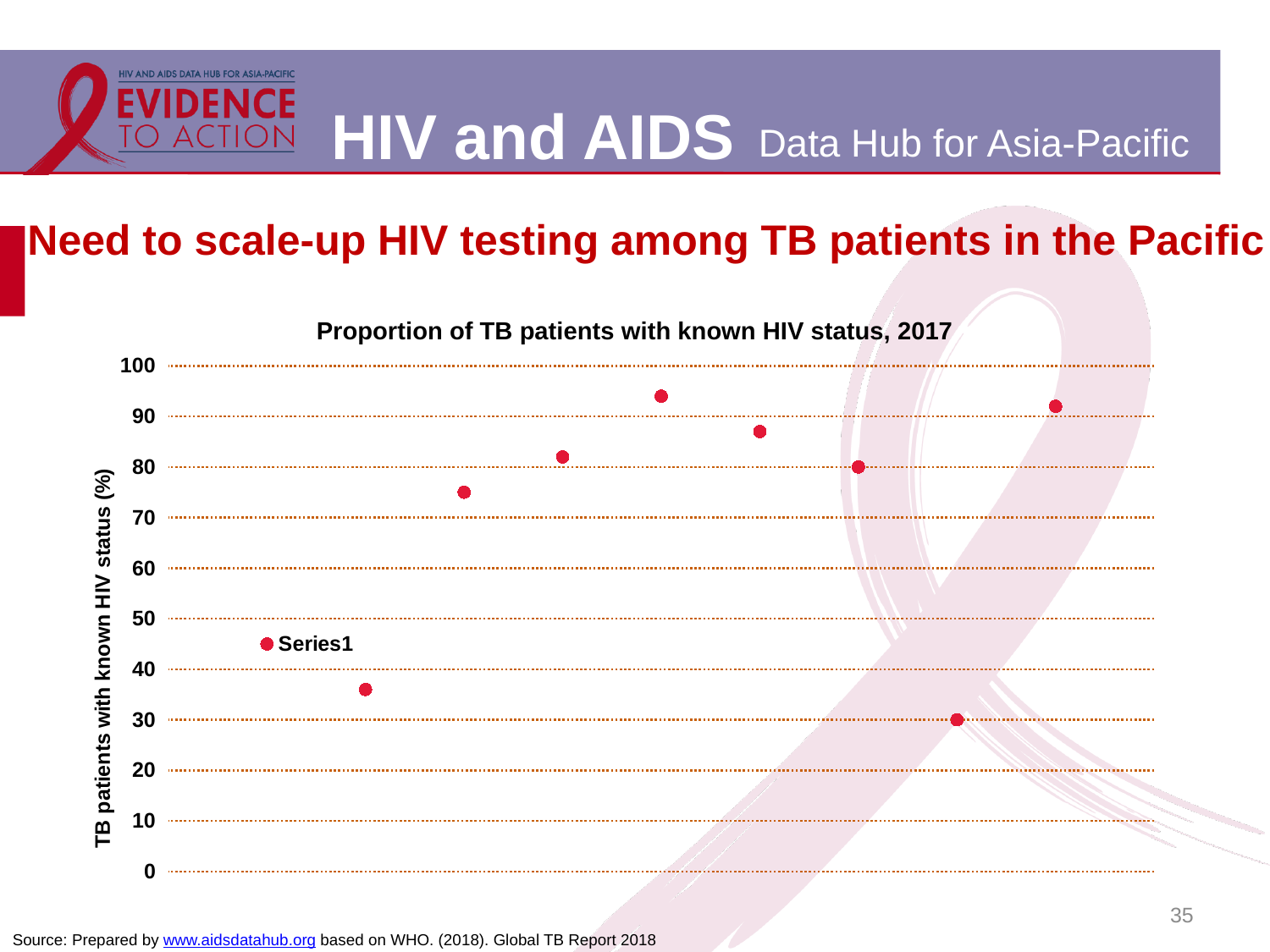
Is the value of the leftmost data point greater or less than 40? greater What is the title of the chart? Proportion of TB patients with known HIV status, 2017 Is the value of the highest data point greater or less than 90? greater How many data points are plotted on the chart? 9 Is the value of the rightmost data point greater or less than 90? greater What is the highest value shown on the vertical axis? 100 What is the label of the vertical axis? TB patients with known HIV status (%) What kind of chart is shown on the slide? Scatter (dot) chart Which is larger: the value of the leftmost data point or the value of the rightmost data point? The rightmost data point